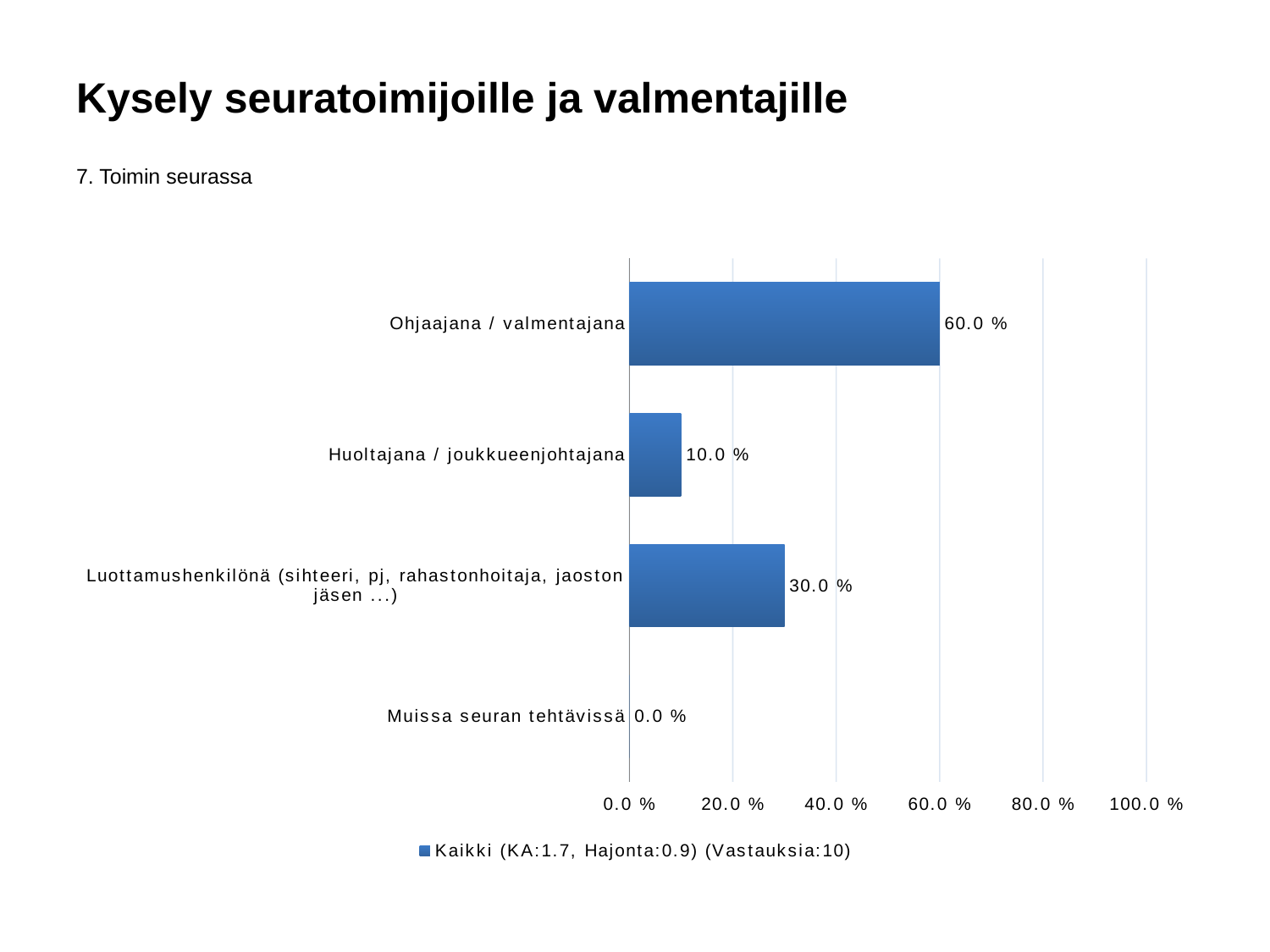
What is the value for Ohjaajana / valmentajana? 60.0 % What is the difference between the values for Ohjaajana / valmentajana and Luottamushenkilönä (sihteeri, pj, rahastonhoitaja, jaoston jäsen ...)? 30.0 % Is the value for Ohjaajana / valmentajana greater or less than 40.0 %? greater Which category has the lowest value? Muissa seuran tehtävissä What is the value for Huoltajana / joukkueenjohtajana? 10.0 % What is the value for Luottamushenkilönä (sihteeri, pj, rahastonhoitaja, jaoston jäsen ...)? 30.0 % Which is larger, the value for Huoltajana / joukkueenjohtajana or the value for Luottamushenkilönä (sihteeri, pj, rahastonhoitaja, jaoston jäsen ...)? Luottamushenkilönä (sihteeri, pj, rahastonhoitaja, jaoston jäsen ...) What is the value for Muissa seuran tehtävissä? 0.0 % Which category has the highest value? Ohjaajana / valmentajana How many categories are shown in the chart? 4 What is the legend entry for the series in the chart? Kaikki (KA:1.7, Hajonta:0.9) (Vastauksia:10) What kind of chart is shown on the slide? bar chart